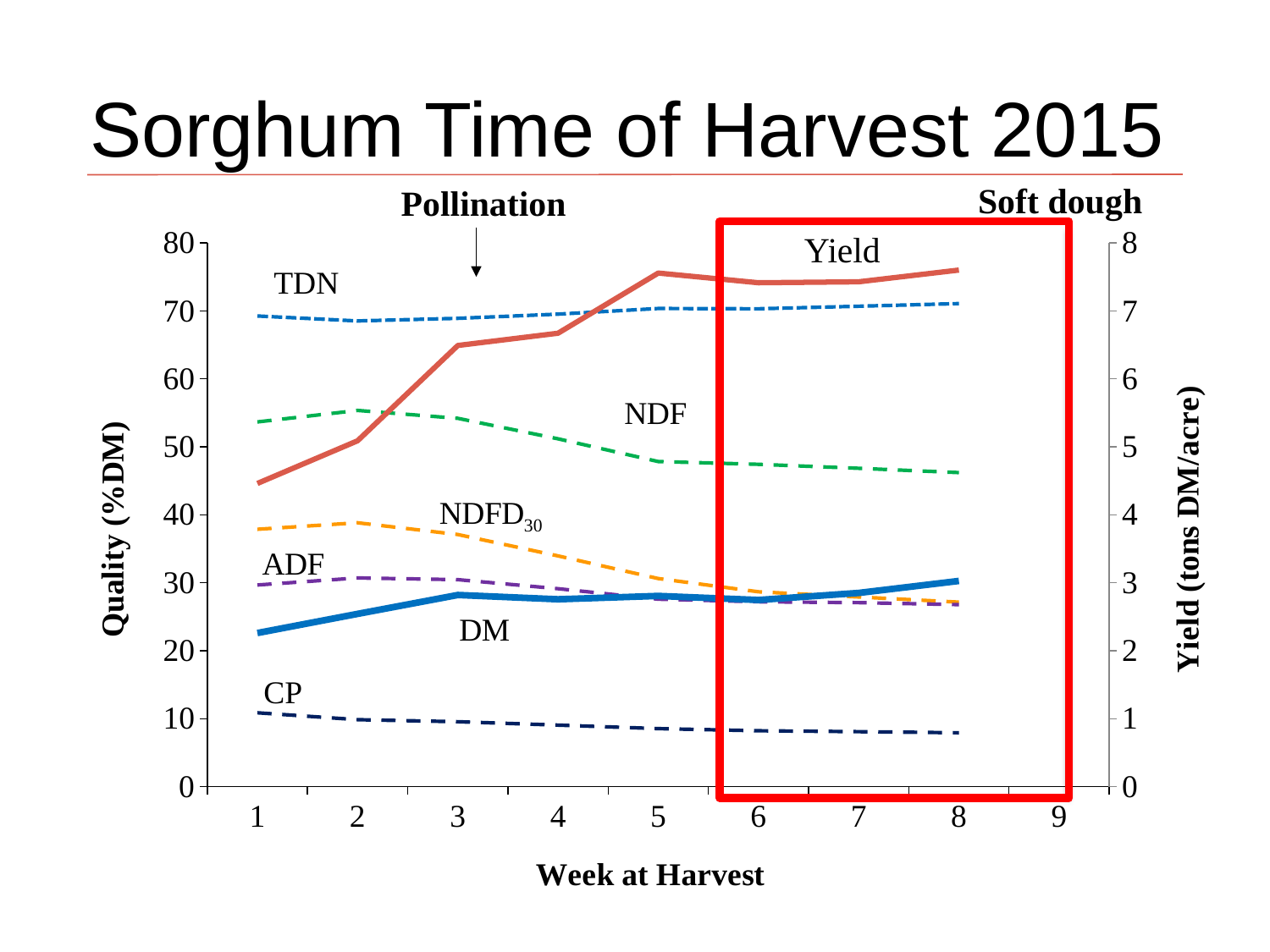
How many week labels are shown on the x axis? 9 Is the DM value at week 1 greater or less than 30? less Which series has the highest quality value at week 1? TDN How many data series are labeled on the chart? 7 Is the TDN value at week 1 greater or less than 60? greater Is the Yield value at week 1 greater or less than 5 tons DM/acre? less What is the title of the x axis? Week at Harvest Does the CP line rise or fall from week 1 to week 8? fall Which series has the lowest quality value at week 8? CP Does the NDF line rise or fall from week 2 to week 8? fall What kind of chart is shown on the slide? line chart Does the Yield line rise or fall from week 1 to week 8? rise